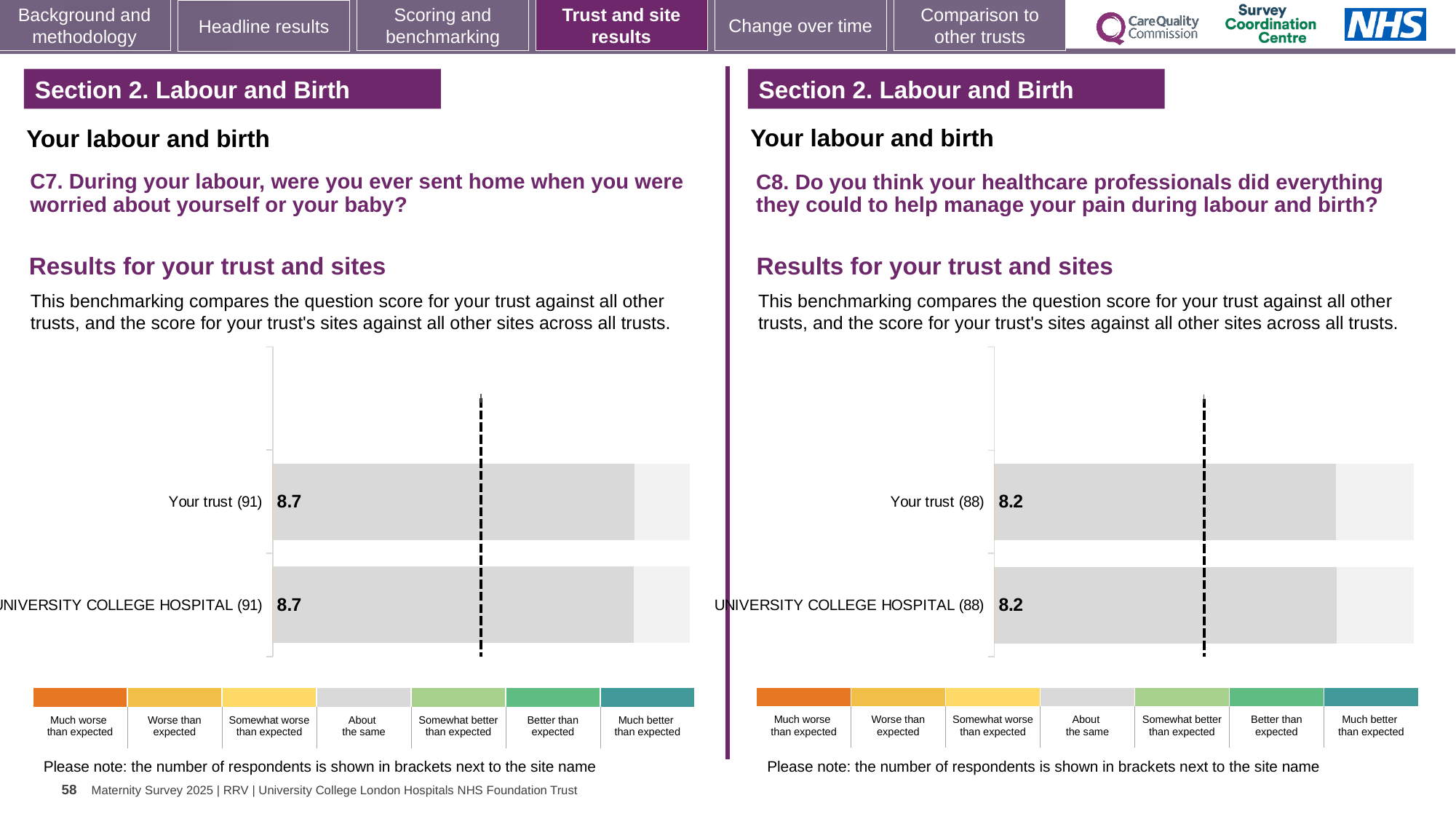
How many bars are plotted in the C8 chart on the right? 2 How many bars are plotted in the C7 chart on the left? 2 In the C7 chart on the left, how many respondents are shown in brackets for Your trust? 91 In the C8 chart on the right, how many respondents are shown in brackets for UNIVERSITY COLLEGE HOSPITAL? 88 In the C8 chart on the right, what is the score for Your trust? 8.2 In the C7 chart on the left, what is the score for UNIVERSITY COLLEGE HOSPITAL? 8.7 In the C8 chart on the right, what is the score for UNIVERSITY COLLEGE HOSPITAL? 8.2 What is the difference between the Your trust score in the C7 chart on the left and the Your trust score in the C8 chart on the right? 0.5 In the C8 chart on the right, is the score for Your trust the same as the score for UNIVERSITY COLLEGE HOSPITAL? Yes, both are 8.2 What kind of chart is used for the C7 results on the left? Bar chart In the C7 chart on the left, what is the score for Your trust? 8.7 Which is larger: the Your trust score in the C7 chart on the left or the Your trust score in the C8 chart on the right? C7 chart (8.7)